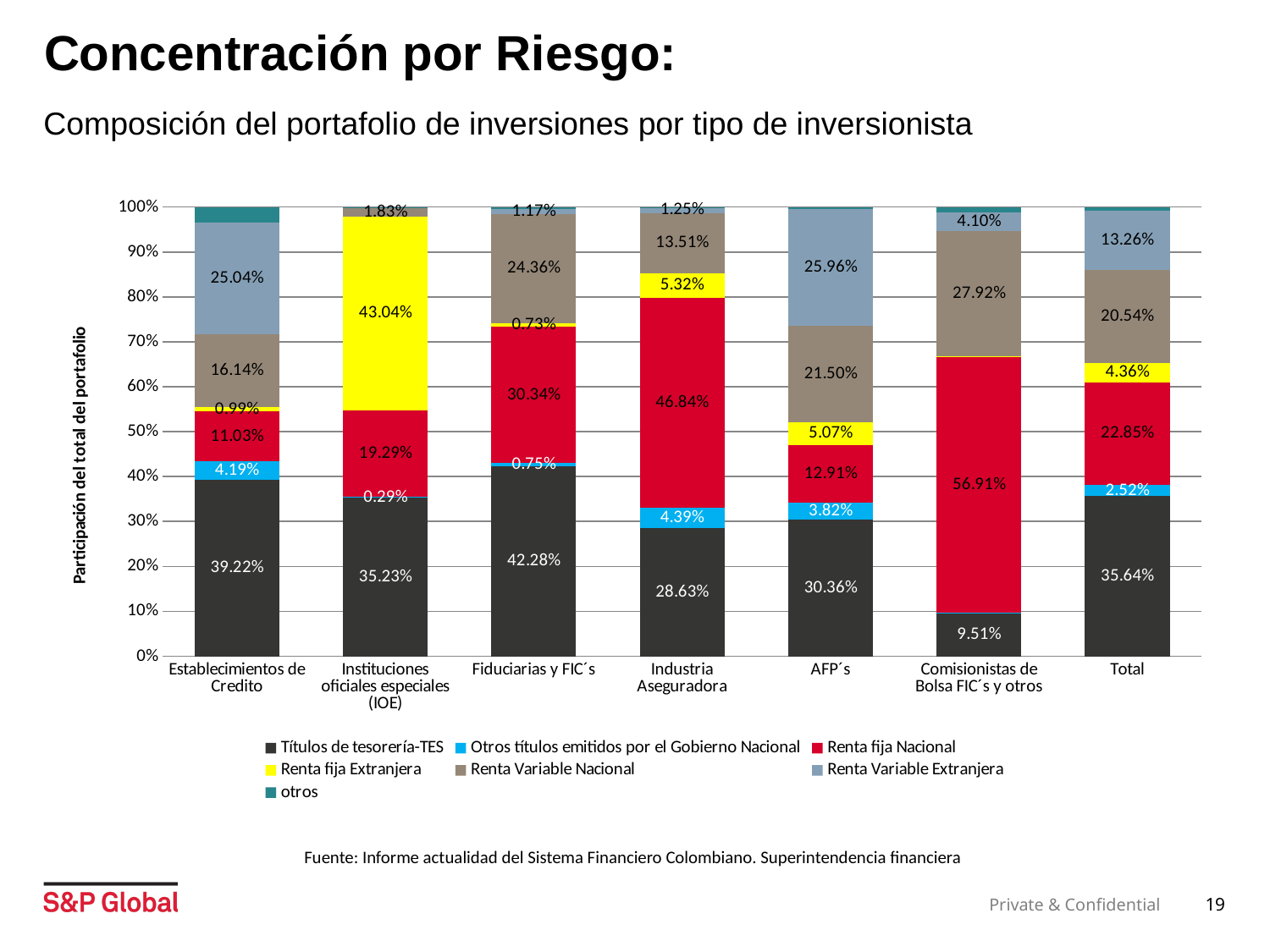
What is the share of Títulos de tesorería-TES for Fiduciarias y FIC´s? 42.28% How many series does the legend list? 7 Which is larger: the Renta Variable Extranjera share for AFP´s or for Establecimientos de Credito? AFP´s Which investor type has the highest share of Títulos de tesorería-TES? Fiduciarias y FIC´s What is the share of Renta fija Nacional for Comisionistas de Bolsa FIC´s y otros? 56.91% What is the difference between the Renta fija Nacional share for Industria Aseguradora and for AFP´s? 33.93% How many investor types (categories) are shown on the x axis? 7 What is the share of Renta fija Extranjera for Instituciones oficiales especiales (IOE)? 43.04% Which investor type has the lowest share of Títulos de tesorería-TES? Comisionistas de Bolsa FIC´s y otros What is the share of Renta Variable Extranjera in the Total bar? 13.26% What is the label of the y axis? Participación del total del portafolio What kind of chart is shown on the slide? Stacked bar chart